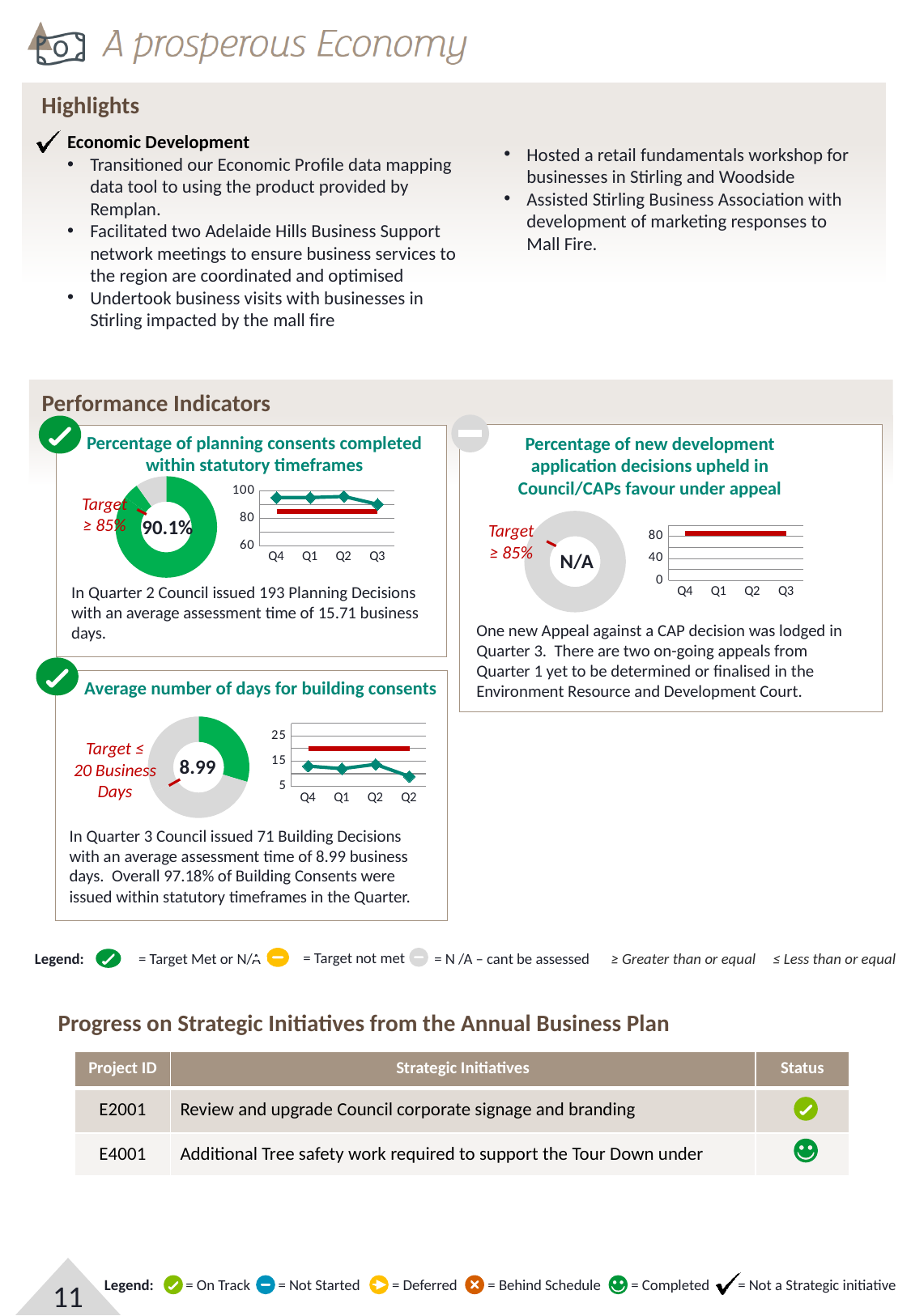
In the line chart for 'Average number of days for building consents', is the last point higher or lower than the first point (Q4)? lower What is the target stated next to the 'Average number of days for building consents' chart? ≤ 20 Business Days What kind of chart is the small chart with quarters on the x axis in the 'Average number of days for building consents' panel? line chart In the 'Percentage of new development application decisions upheld in Council/CAPs favour under appeal' donut chart, what is shown in the centre? N/A In the line chart for 'Average number of days for building consents', is the value at the last point on the x axis greater or less than 15? less How many quarters are shown on the x axis of the line chart for 'Percentage of planning consents completed within statutory timeframes'? 4 In the line chart for 'Average number of days for building consents', is the Q4 value greater or less than 25? less In the line chart for 'Percentage of planning consents completed within statutory timeframes', is the Q3 value greater or less than 80? greater In the 'Average number of days for building consents' donut chart, what value is shown in the centre? 8.99 What is the target stated next to the 'Percentage of planning consents completed within statutory timeframes' chart? ≥ 85% In the 'Percentage of planning consents completed within statutory timeframes' donut chart, what value is shown in the centre? 90.1%